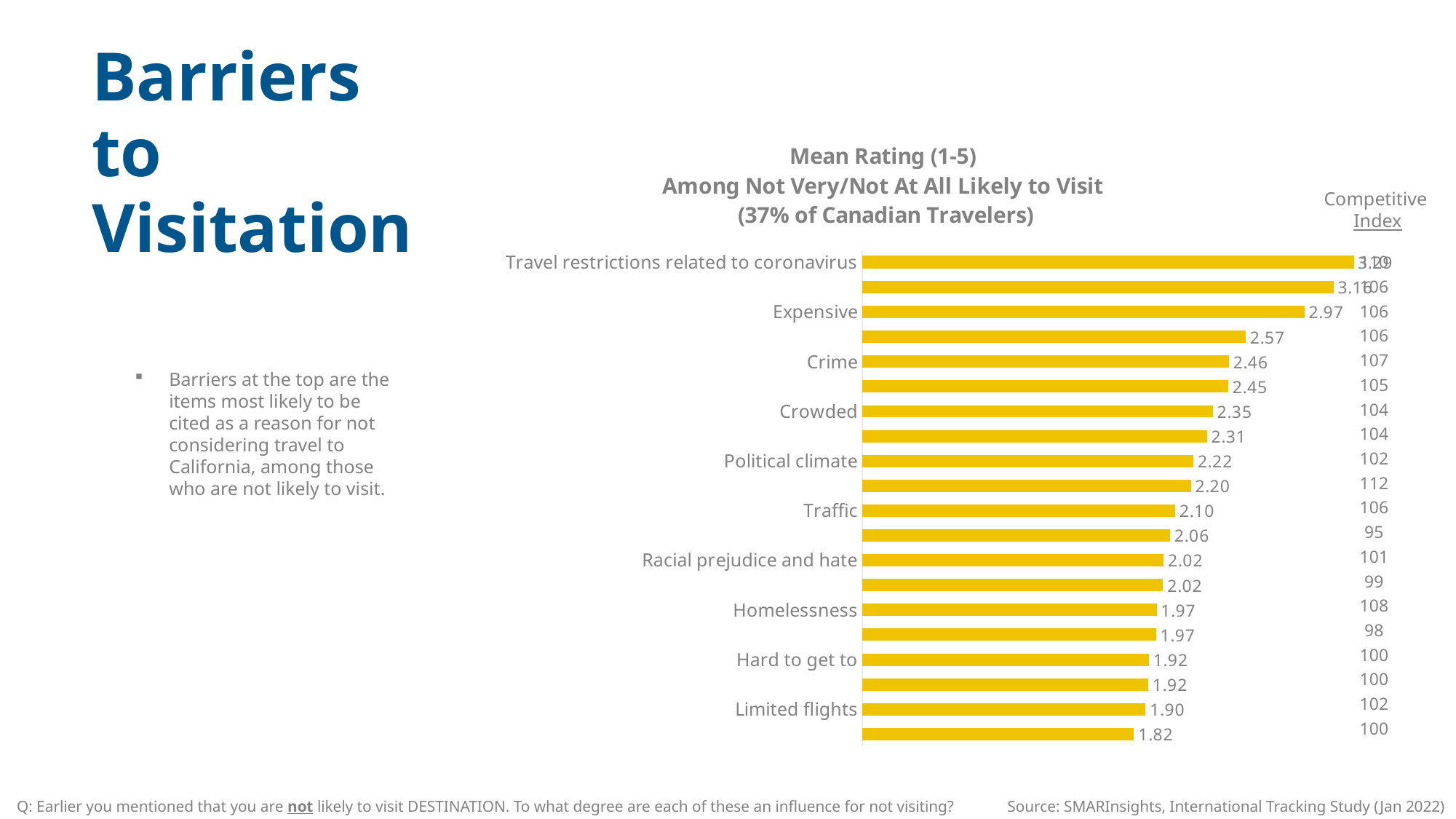
What is the mean rating for Expensive? 2.97 What is the mean rating for Political climate? 2.22 How many bars are plotted in the chart? 20 Do the bars get longer or shorter going from the top of the chart to the bottom? shorter Which labeled barrier has the highest mean rating? Travel restrictions related to coronavirus What is the mean rating for Limited flights? 1.90 Which has a higher mean rating, Homelessness or Hard to get to? Homelessness What is the mean rating for Crime? 2.46 What is the difference between the mean ratings for Expensive and Crime? 0.51 What is the mean rating for Traffic? 2.10 What is the mean rating for Crowded? 2.35 What kind of chart is shown on the slide? bar chart